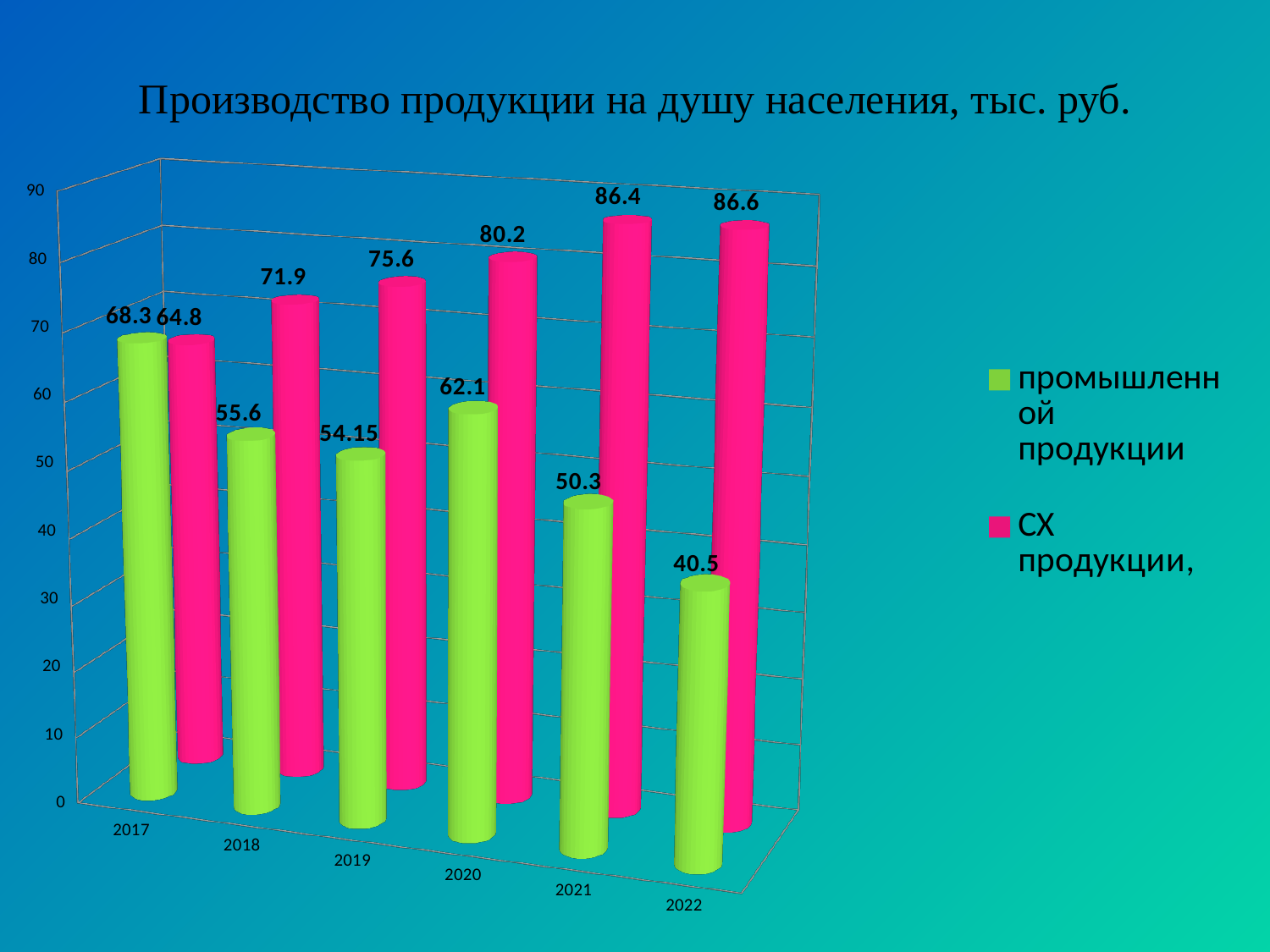
What kind of chart is shown on the slide? bar chart How many series does the legend list? 2 In which year is the value for СХ продукции highest? 2022 What is the value for промышленной продукции in 2017? 68.3 How many years are shown on the x axis? 6 Does the value for СХ продукции rise or fall from 2017 to 2022? rise Is the value for промышленной продукции in 2021 greater or less than 60? less What is the value for промышленной продукции in 2019? 54.15 Which is larger in 2017: промышленной продукции or СХ продукции? промышленной продукции In which year is the value for промышленной продукции lowest? 2022 What is the difference between СХ продукции and промышленной продукции in 2022? 46.1 What is the value for СХ продукции in 2020? 80.2